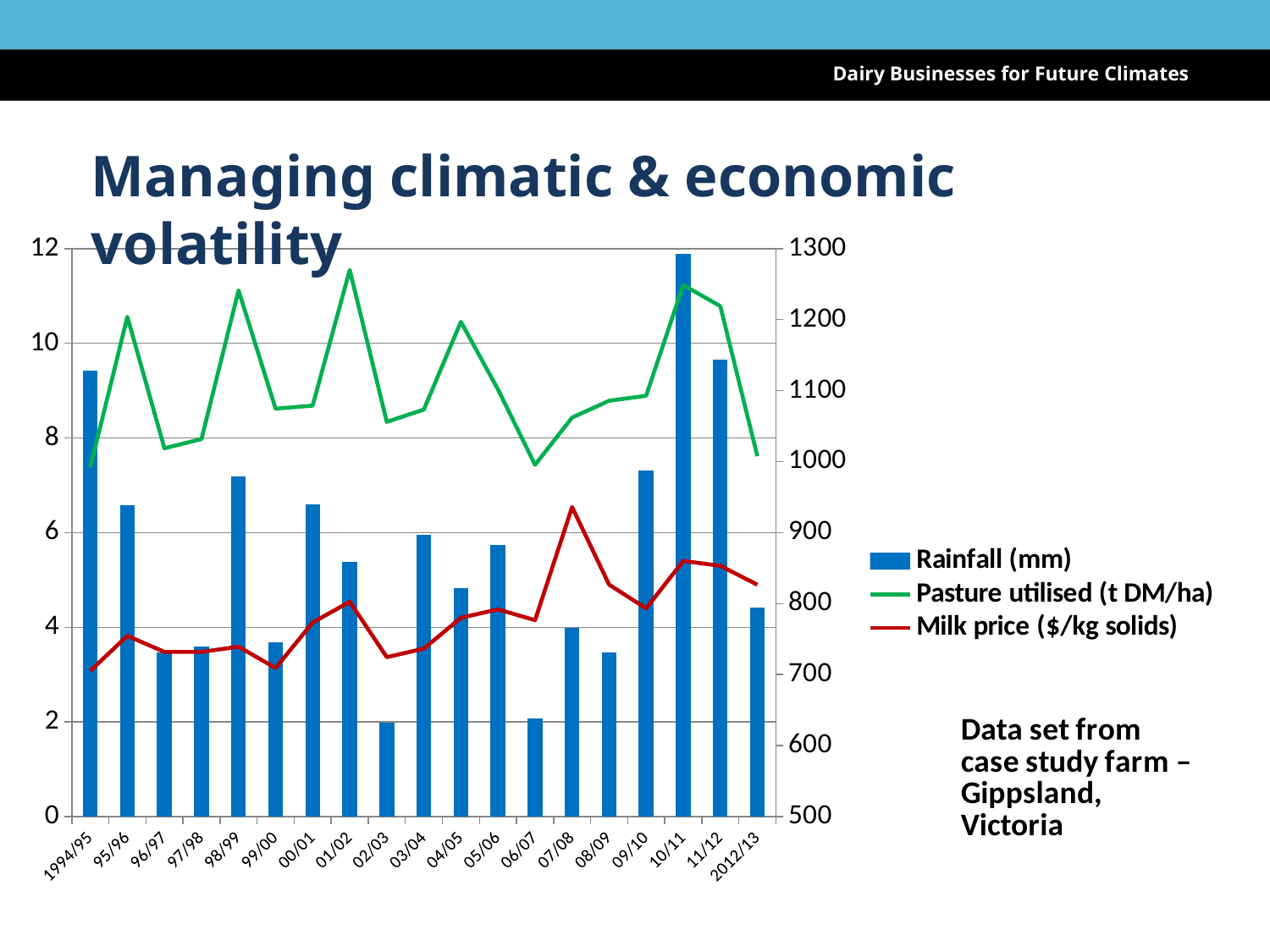
Is the Milk price ($/kg solids) value for 07/08 greater or less than 6? greater Which colour represents Rainfall (mm) in the legend? Blue What kind of chart is shown on the slide? A combination bar and line chart Is the Rainfall (mm) value for 10/11 greater or less than 1200? greater In which season is Rainfall (mm) highest? 10/11 Is the Pasture utilised (t DM/ha) value for 01/02 greater or less than 10? greater How many series does the legend list? 3 Which season has the higher Pasture utilised (t DM/ha), 96/97 or 98/99? 98/99 How many seasons (categories) are shown along the x axis? 19 Which season has the higher Rainfall (mm), 10/11 or 11/12? 10/11 In which season is Milk price ($/kg solids) highest? 07/08